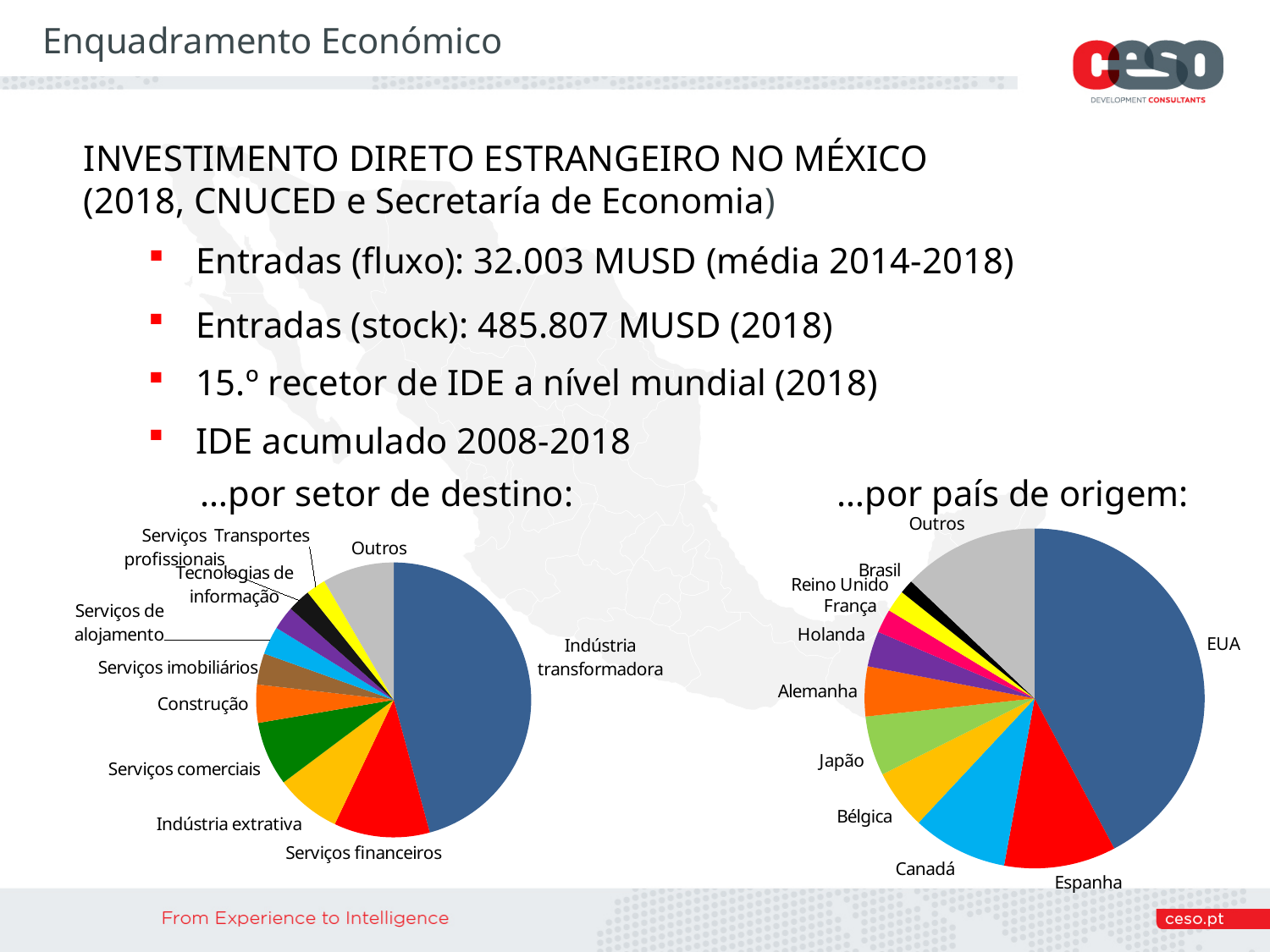
What colour is the EUA slice in the "…por país de origem" chart? blue In the "…por país de origem" chart, which slice is larger, Canadá or Brasil? Canadá In the "…por setor de destino" chart, which slice is larger, Serviços financeiros or Transportes? Serviços financeiros In the "…por setor de destino" chart, which sector has the largest slice? Indústria transformadora How many slices does the "…por país de origem" chart have? 11 What is the title of the pie chart on the right of the slide? …por país de origem: How many slices does the "…por setor de destino" chart have? 11 In the "…por país de origem" chart, which country has the largest slice? EUA In the "…por país de origem" chart, which slice is larger, Espanha or Holanda? Espanha What kind of chart is the "…por país de origem" chart? pie chart What kind of chart is the "…por setor de destino" chart? pie chart